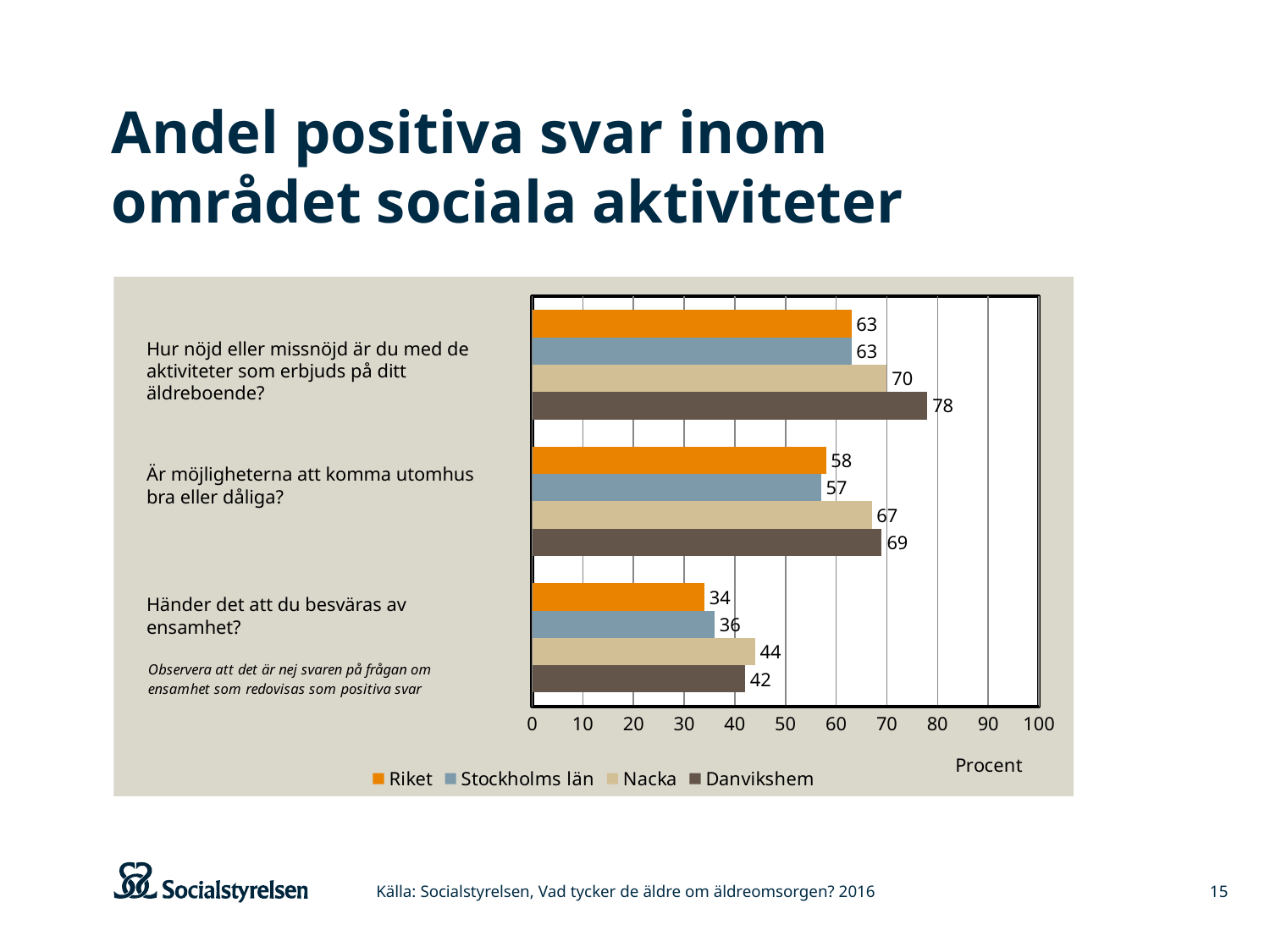
What unit is shown on the x axis of the chart? Procent What is the difference between Danvikshem and Riket on the question 'Hur nöjd eller missnöjd är du med de aktiviteter som erbjuds på ditt äldreboende?' 15 What is the value for Stockholms län on the question 'Är möjligheterna att komma utomhus bra eller dåliga?' 57 Which series has the lowest value for the question 'Händer det att du besväras av ensamhet?' Riket What type of chart is shown on the slide? bar chart What is the value for Riket on the question 'Händer det att du besväras av ensamhet?' 34 How many questions (categories) are shown on the chart? 3 Which is larger on the question 'Händer det att du besväras av ensamhet?': Nacka or Danvikshem? Nacka What is the value for Nacka on the question 'Är möjligheterna att komma utomhus bra eller dåliga?' 67 How many series does the legend list? 4 What is the value for Danvikshem on the question 'Hur nöjd eller missnöjd är du med de aktiviteter som erbjuds på ditt äldreboende?' 78 Which series has the highest value for the question 'Hur nöjd eller missnöjd är du med de aktiviteter som erbjuds på ditt äldreboende?' Danvikshem